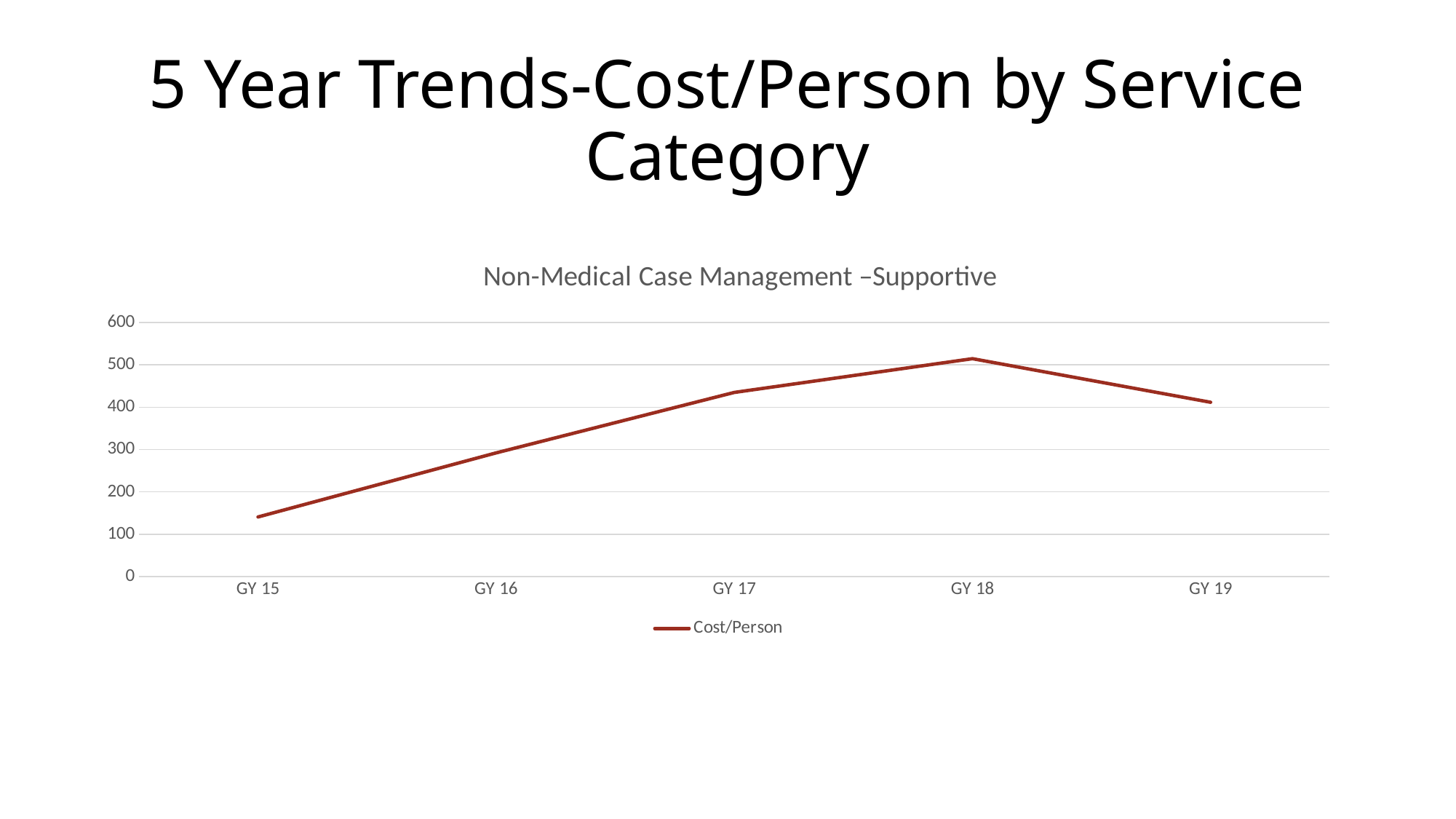
What is the title of the chart? Non-Medical Case Management –Supportive Does Cost/Person rise or fall from GY 15 to GY 18? rise In which grant year is Cost/Person lowest? GY 15 Is the Cost/Person value for GY 18 greater or less than 500? greater Which has a larger Cost/Person, GY 17 or GY 16? GY 17 In which grant year is Cost/Person highest? GY 18 How many grant years are plotted on the x axis? 5 Is the Cost/Person value for GY 16 greater or less than 200? greater What is the name of the series shown in the legend? Cost/Person Is the Cost/Person value for GY 15 greater or less than 200? less How many series does the legend list? 1 What kind of chart is shown on the slide? line chart